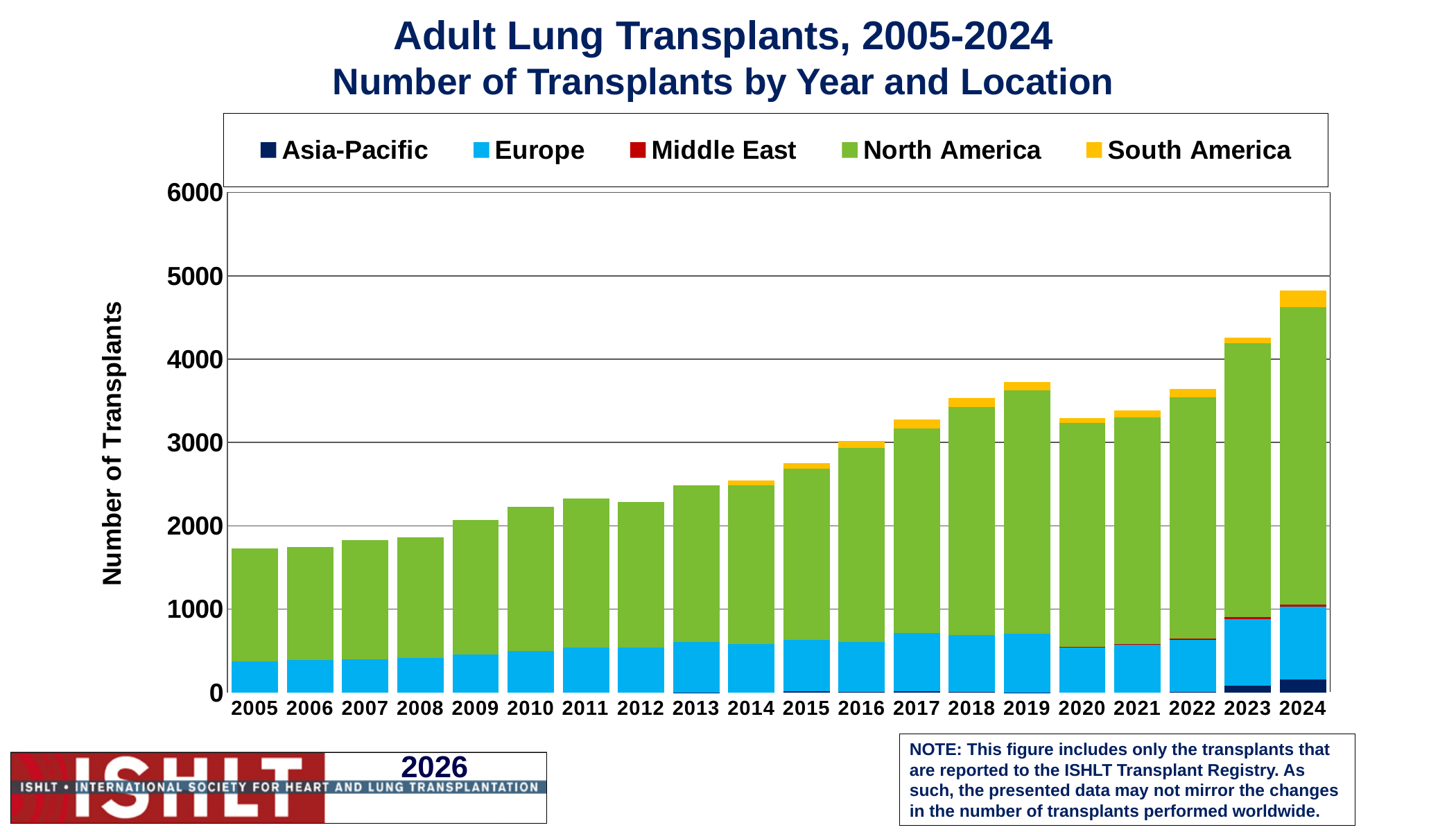
How many years are shown along the x axis of the chart? 20 Which year has a larger total number of transplants, 2019 or 2020? 2019 Is the total number of transplants in 2005 greater or less than 2000? less Which year has a larger total number of transplants, 2023 or 2024? 2024 Is the total number of transplants in 2019 greater or less than 4000? less Is the total number of transplants in 2024 greater or less than 4000? greater Do the total numbers of transplants generally rise or fall from 2005 to 2024? rise What kind of chart is shown on the slide? Stacked bar chart Which year has the highest total number of transplants? 2024 Which location accounts for the largest segment of each bar? North America How many series does the legend list? 5